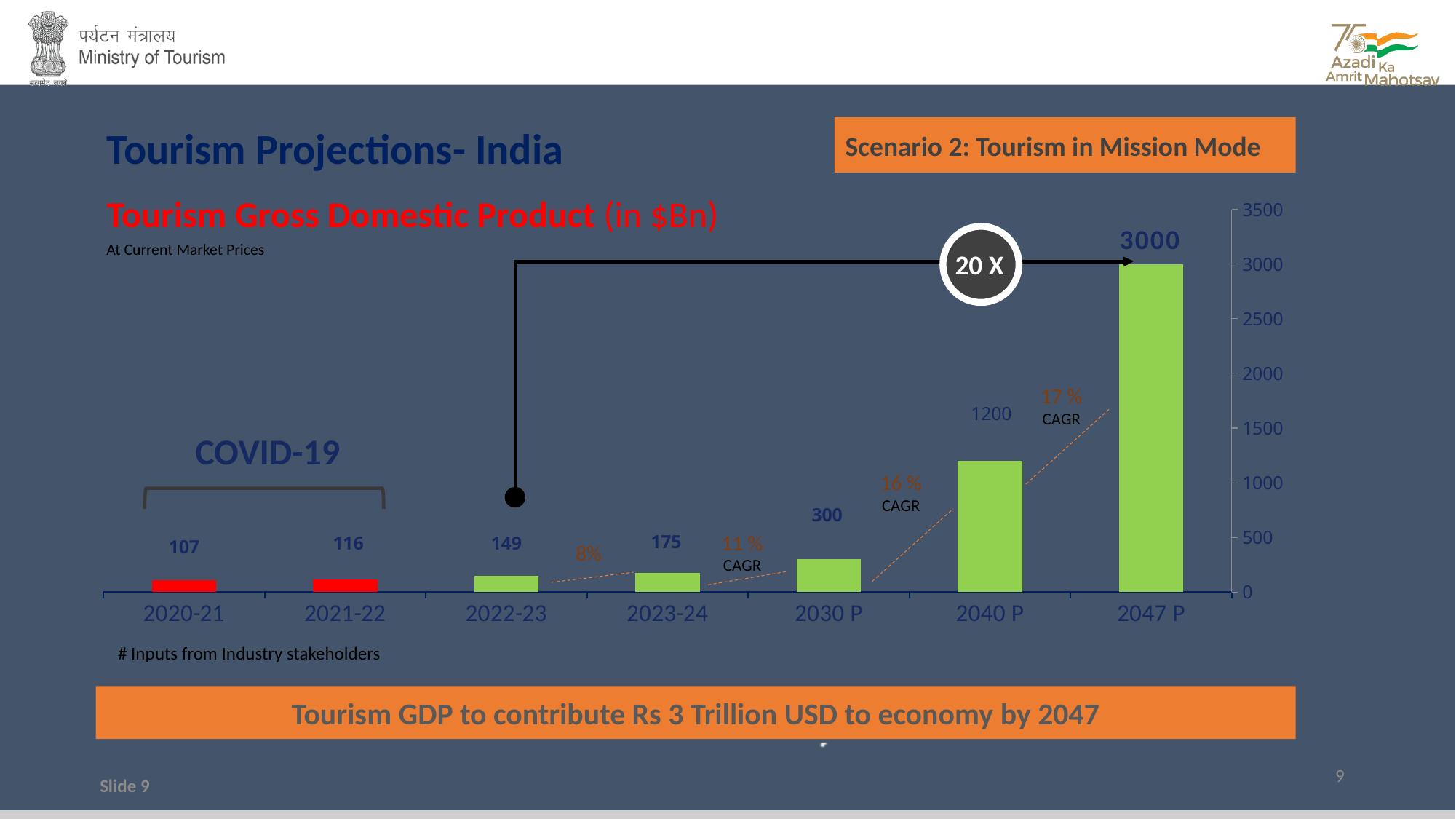
Which category has the lowest value? 2020-21 What is the difference between the values for 2021-22 and 2020-21? 9 What kind of chart is shown on the slide? bar chart What is the value shown for 2023-24? 175 What is the difference between the values for 2040 P and 2030 P? 900 Which category has the highest value? 2047 P What is the Tourism Gross Domestic Product value for 2047 P? 3000 What is the value shown for 2020-21? 107 Which is larger, the value for 2022-23 or the value for 2023-24? 2023-24 How many categories are shown on the x axis? 7 Do the values rise or fall from 2020-21 to 2047 P? rise What is the value shown for 2030 P? 300